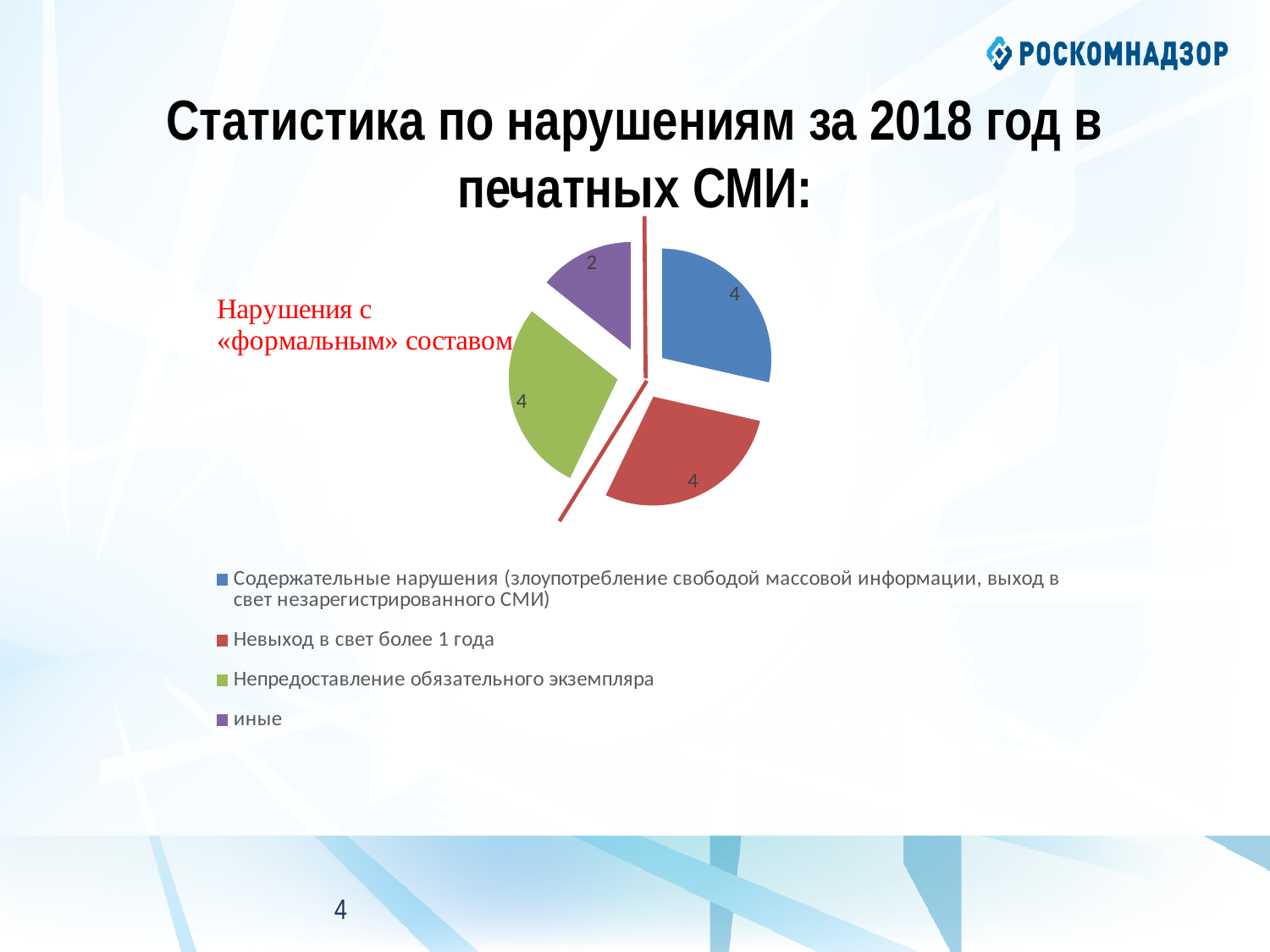
What is the value for the slice "иные"? 2 What is the value for "Содержательные нарушения (злоупотребление свободой массовой информации, выход в свет незарегистрированного СМИ)"? 4 What is the difference between the value for "Невыход в свет более 1 года" and the value for "иные"? 2 How many slices does the pie chart have? 4 What is the value for "Непредоставление обязательного экземпляра"? 4 What colour is the slice for "иные"? purple Which category has the smallest slice in the pie chart? иные What is the total of all slices in the pie chart? 14 Which is larger: the value for "Непредоставление обязательного экземпляра" or the value for "иные"? Непредоставление обязательного экземпляра What kind of chart is shown on the slide? pie chart How many entries does the legend list? 4 What is the value for "Невыход в свет более 1 года"? 4